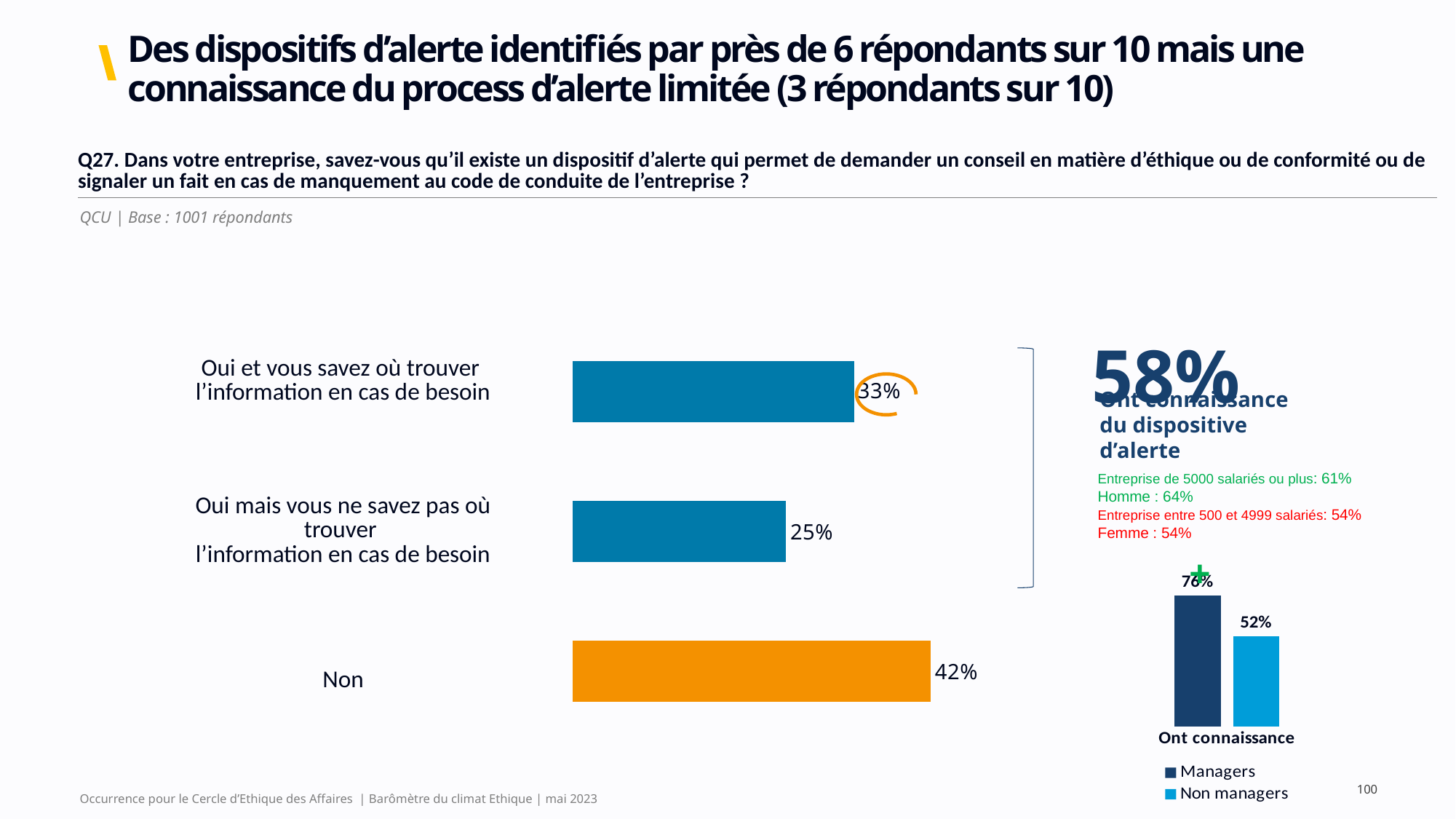
In the horizontal bar chart on the left, what is the value for "Oui mais vous ne savez pas où trouver l'information en cas de besoin"? 25% In the small "Ont connaissance" bar chart on the right, how many series does the legend list? 2 In the horizontal bar chart on the left, what is the value for "Non"? 42% In the horizontal bar chart on the left, which category has the lowest value? Oui mais vous ne savez pas où trouver l'information en cas de besoin In the horizontal bar chart on the left, which category has the highest value? Non In the small "Ont connaissance" bar chart on the right, what is the value for Non managers? 52% In the horizontal bar chart on the left, how many categories are shown? 3 In the horizontal bar chart on the left, which bar is shown in orange? Non In the horizontal bar chart on the left, what is the value for "Oui et vous savez où trouver l'information en cas de besoin"? 33% In the small "Ont connaissance" bar chart on the right, which is larger, Managers or Non managers? Managers What kind of chart is the chart on the left of the slide? Bar chart In the horizontal bar chart on the left, what is the difference between the value for "Non" and the value for "Oui et vous savez où trouver l'information en cas de besoin"? 9%